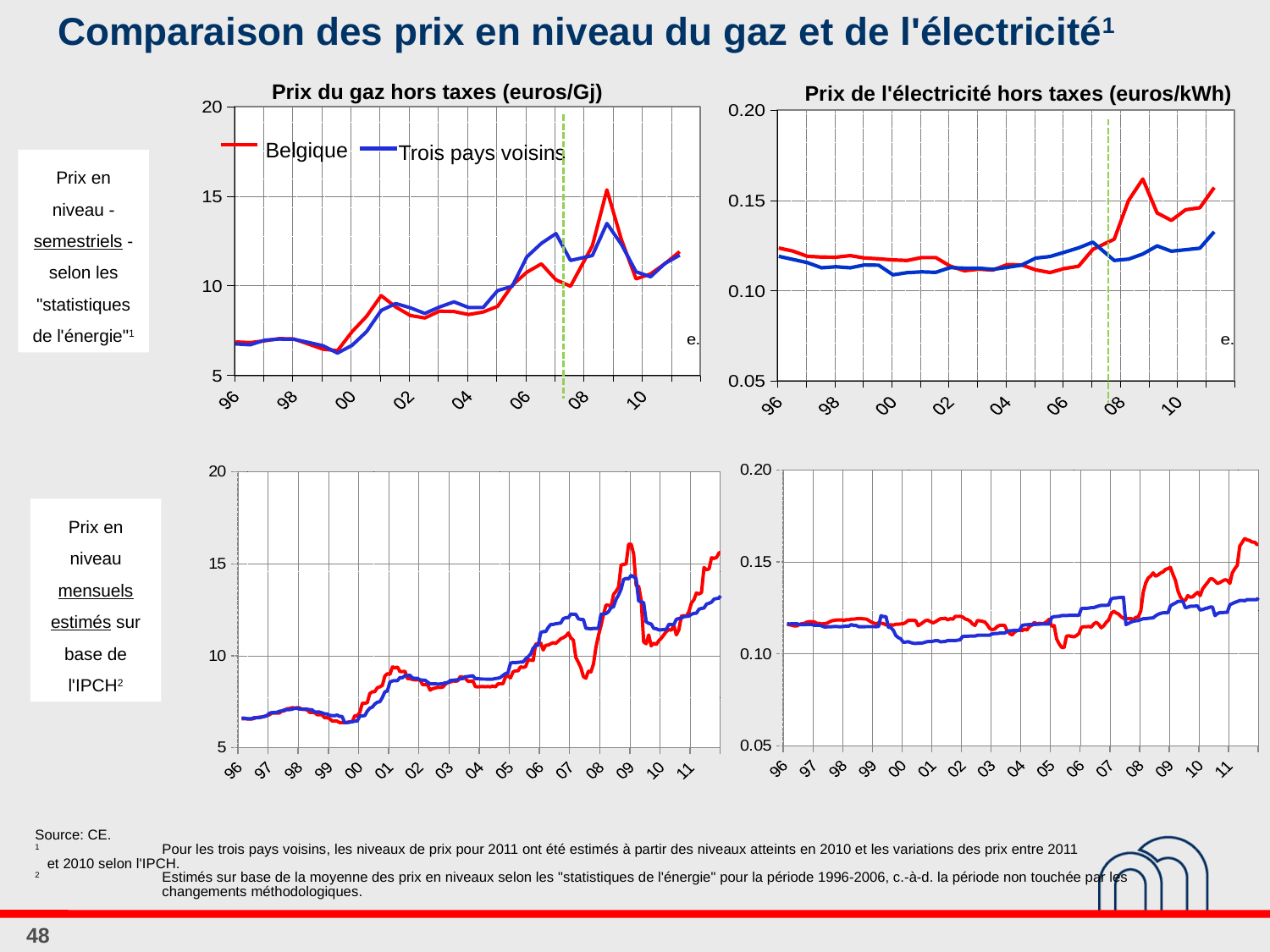
In the top-left gas chart, is the Belgique value at its 2009 peak greater or less than 10? greater In the top-right electricity chart, is the Belgique value at its 2009 peak greater or less than 0.15? greater What are the two series named in the legend of the top-left gas chart? Belgique and Trois pays voisins In the top-left gas chart, at the 2009 peak, which series is higher, Belgique or Trois pays voisins? Belgique In the top-right electricity chart, is the Trois pays voisins value in 2011 greater or less than 0.15? less In the bottom-left gas chart, do the values overall rise or fall from 1996 to 2011? rise What kind of chart is the top-left chart titled 'Prix du gaz hors taxes (euros/Gj)'? line chart What is the title of the top-right chart? Prix de l'électricité hors taxes (euros/kWh) How many series does the legend of the top-left gas chart list? 2 In the top-right electricity chart, around 2009, which series is higher, Belgique or Trois pays voisins? Belgique